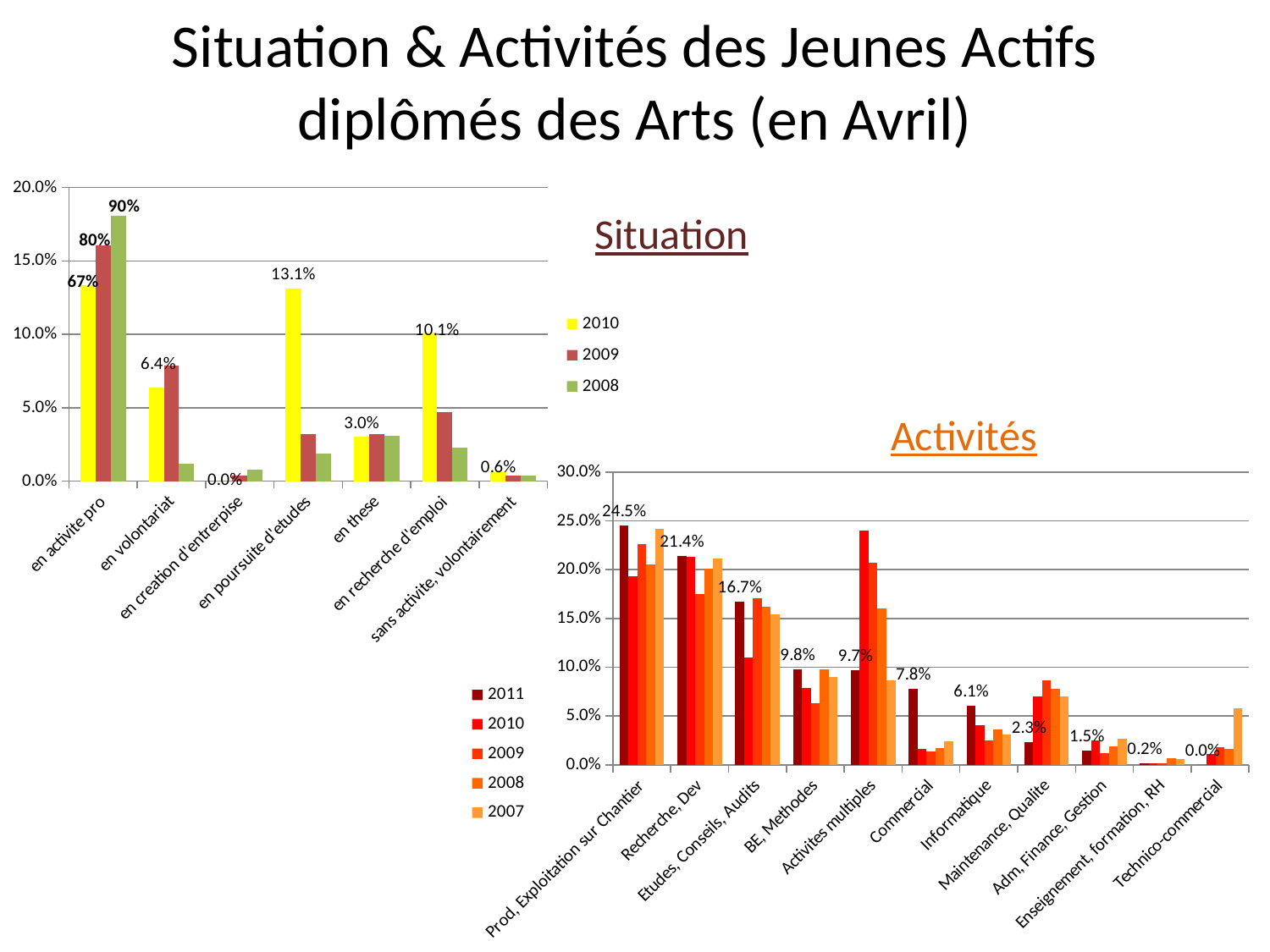
On the Activités chart, what is the 2011 value for 'Prod, Exploitation sur Chantier'? 24.5% On the Activités chart, which category has the highest 2011 value? Prod, Exploitation sur Chantier On the Situation chart, what is the 2010 value for 'en poursuite d'etudes'? 13.1% On the Situation chart, how many series does the legend list? 3 On the Situation chart, what kind of chart is shown? bar chart On the Activités chart, is the 2010 value for 'Activites multiples' greater or less than 20%? greater On the Situation chart, for 'en volontariat', which is larger: the 2010 bar or the 2009 bar? 2009 On the Situation chart, how many categories are shown on the x axis? 7 On the Situation chart, what is the 2010 value for 'en recherche d'emploi'? 10.1% On the Activités chart, how many categories are shown on the x axis? 11 On the Activités chart, how many series does the legend list? 5 On the Situation chart, what is the difference between the 2010 values for 'en poursuite d'etudes' and 'en recherche d'emploi'? 3.0%